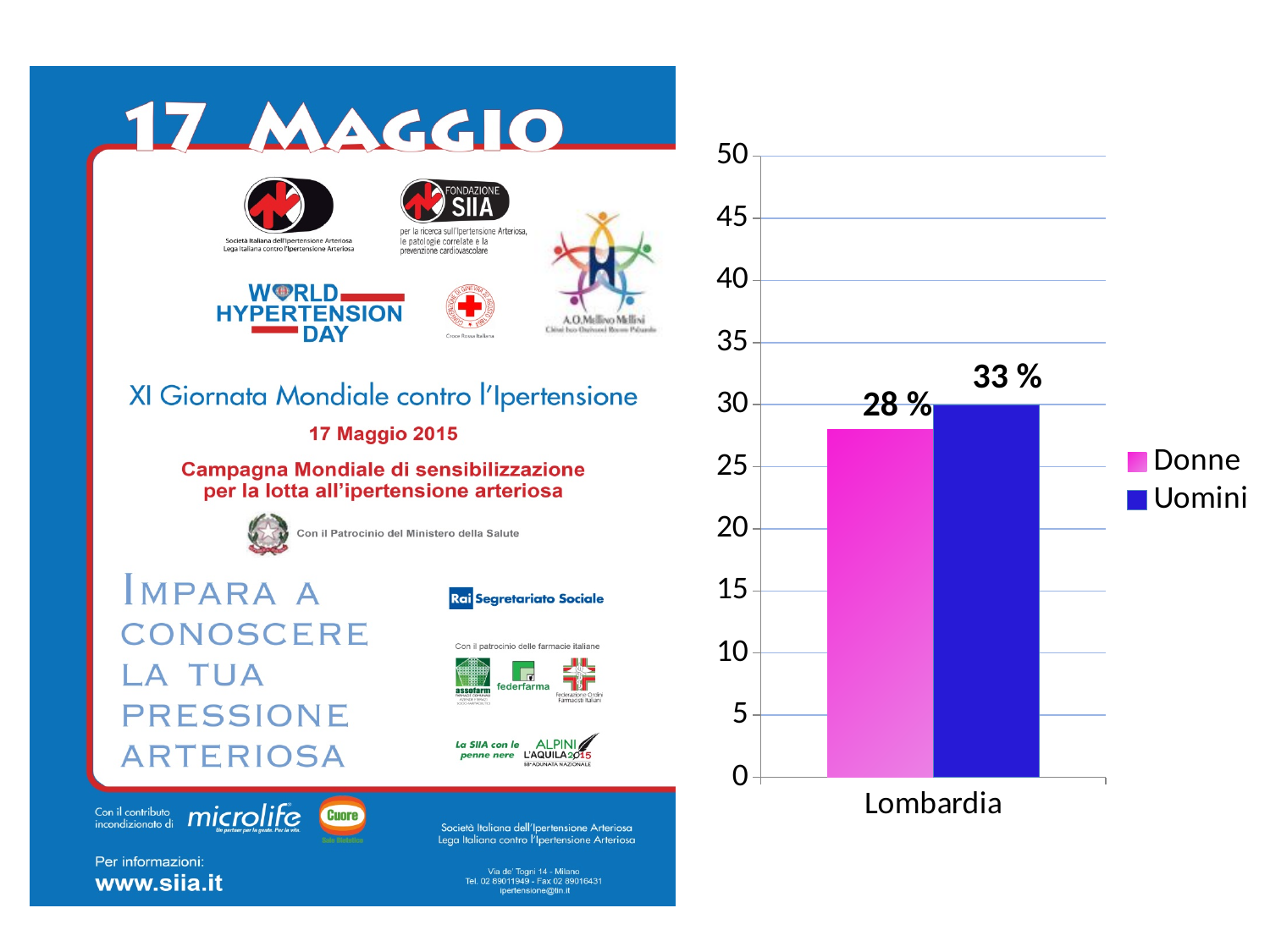
What is the maximum value shown on the y axis? 50 Which series has the higher value in Lombardia, Donne or Uomini? Uomini How many series does the legend list? 2 Which colour represents Donne in the legend? pink What is the category label on the x axis? Lombardia Is the value for Donne in Lombardia greater or less than 30? less What kind of chart is shown on the slide? bar chart What is the difference between the Uomini and Donne values in Lombardia? 5 % What is the value for Uomini in Lombardia? 33 % What is the value for Donne in Lombardia? 28 % How many categories are shown on the x axis? 1